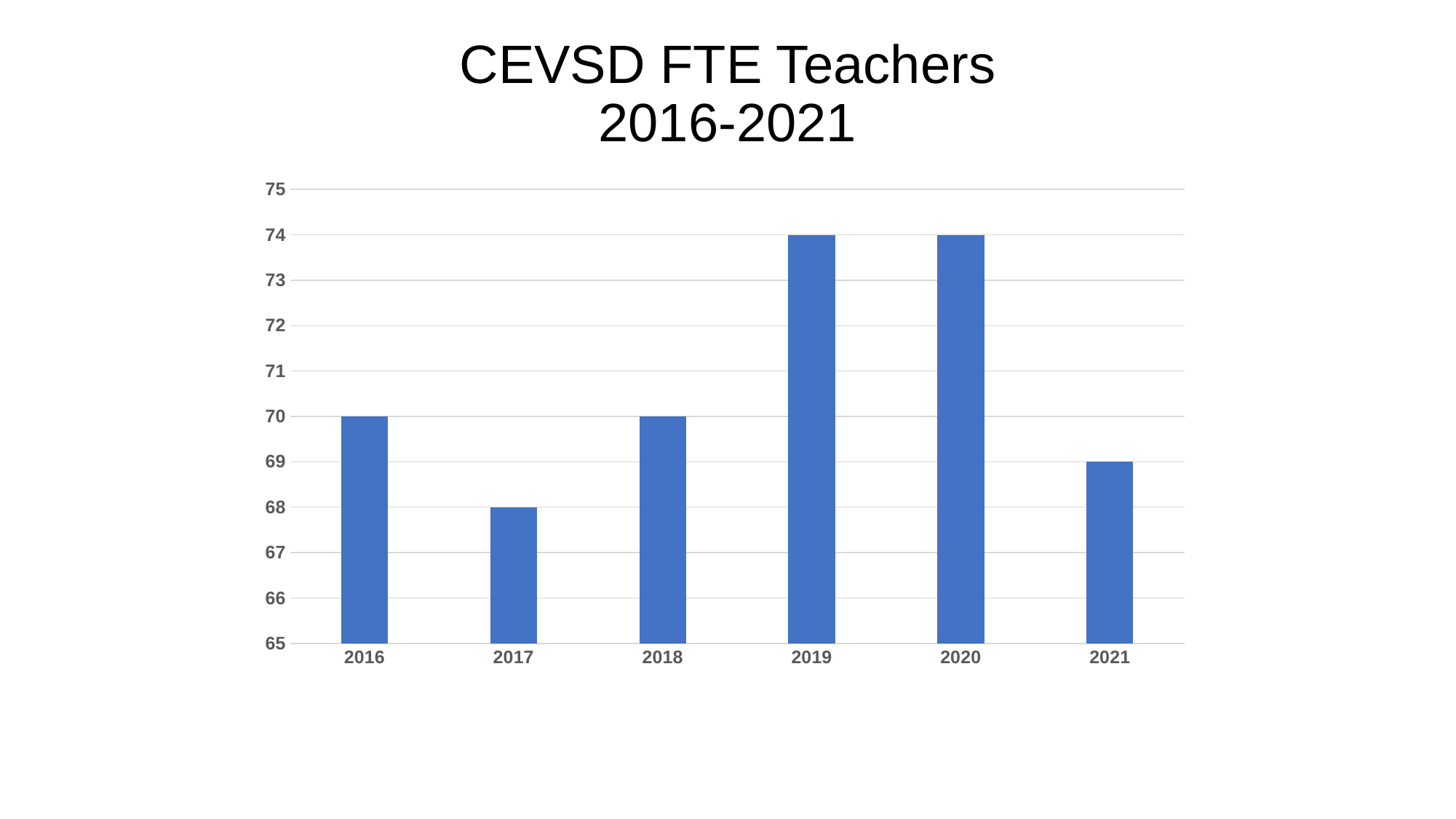
Which is larger, the value for 2018 or the value for 2021? 2018 What is the value for 2021? 69 What is the title of the chart? CEVSD FTE Teachers 2016-2021 Is the value for 2020 greater or less than 72? greater What is the value for 2016? 70 What is the value for 2017? 68 Which year has the lowest value? 2017 What kind of chart is shown on the slide? bar chart What is the difference between the values for 2020 and 2021? 5 What is the value for 2019? 74 How many years are shown on the x axis? 6 What is the difference between the values for 2019 and 2017? 6